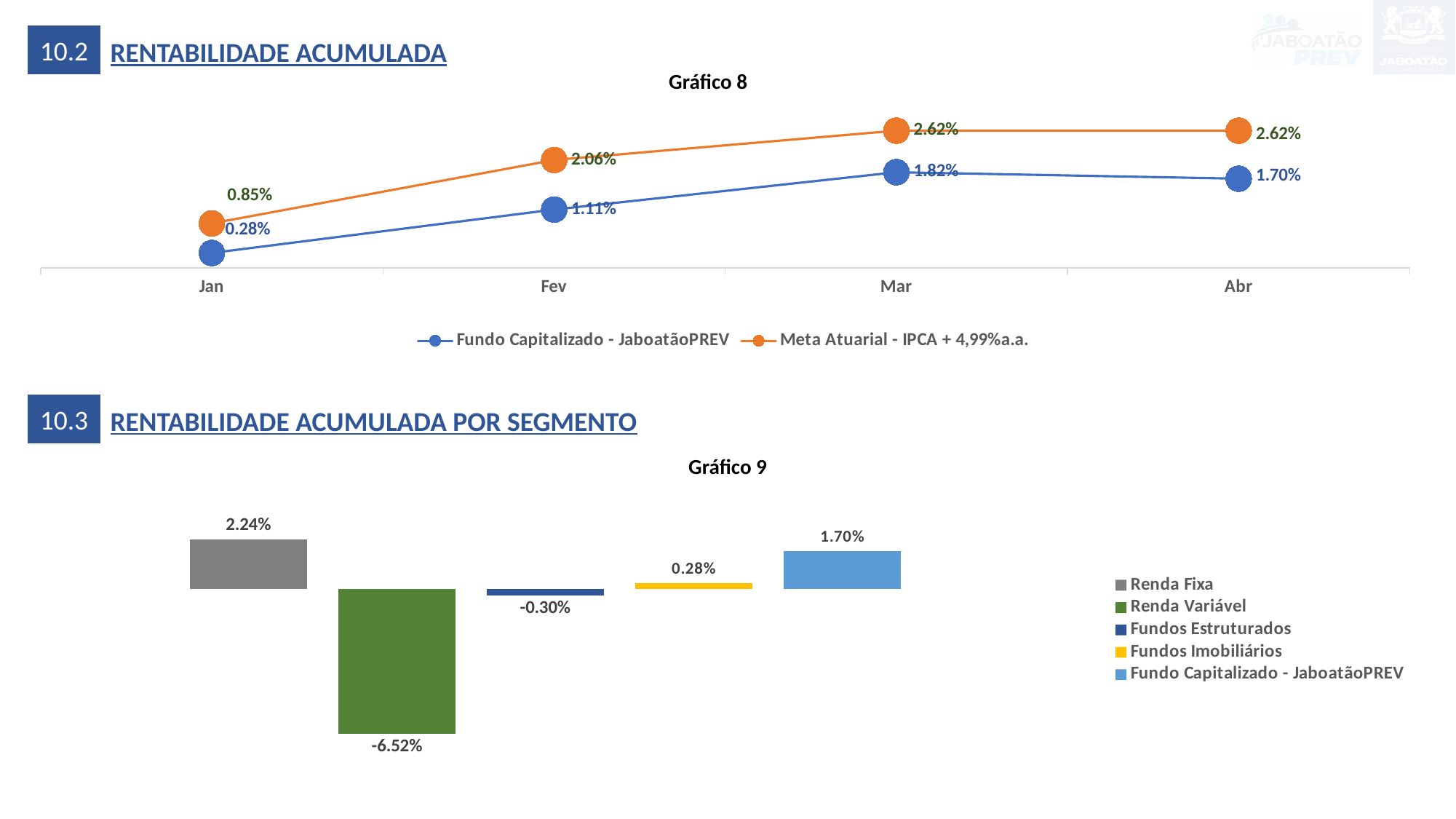
In Gráfico 8, which series has the higher value in Jan? Meta Atuarial - IPCA + 4,99%a.a. In Gráfico 8, what is the value for Meta Atuarial - IPCA + 4,99%a.a. in Fev? 2.06% In Gráfico 9, which segment has the highest value? Renda Fixa In Gráfico 9, what is the difference between Renda Fixa and Fundo Capitalizado - JaboatãoPREV? 0.54% In Gráfico 8, does the Fundo Capitalizado - JaboatãoPREV series rise or fall from Mar to Abr? Fall In Gráfico 9, what is the value for Renda Variável? -6.52% In Gráfico 8, how many months are shown on the x axis? 4 What kind of chart is Gráfico 9? Bar chart What kind of chart is Gráfico 8? Line chart In Gráfico 8, how many series does the legend list? 2 In Gráfico 8, what is the difference between Meta Atuarial and Fundo Capitalizado in Abr? 0.92% In Gráfico 8, what is the value for Fundo Capitalizado - JaboatãoPREV in Mar? 1.82%